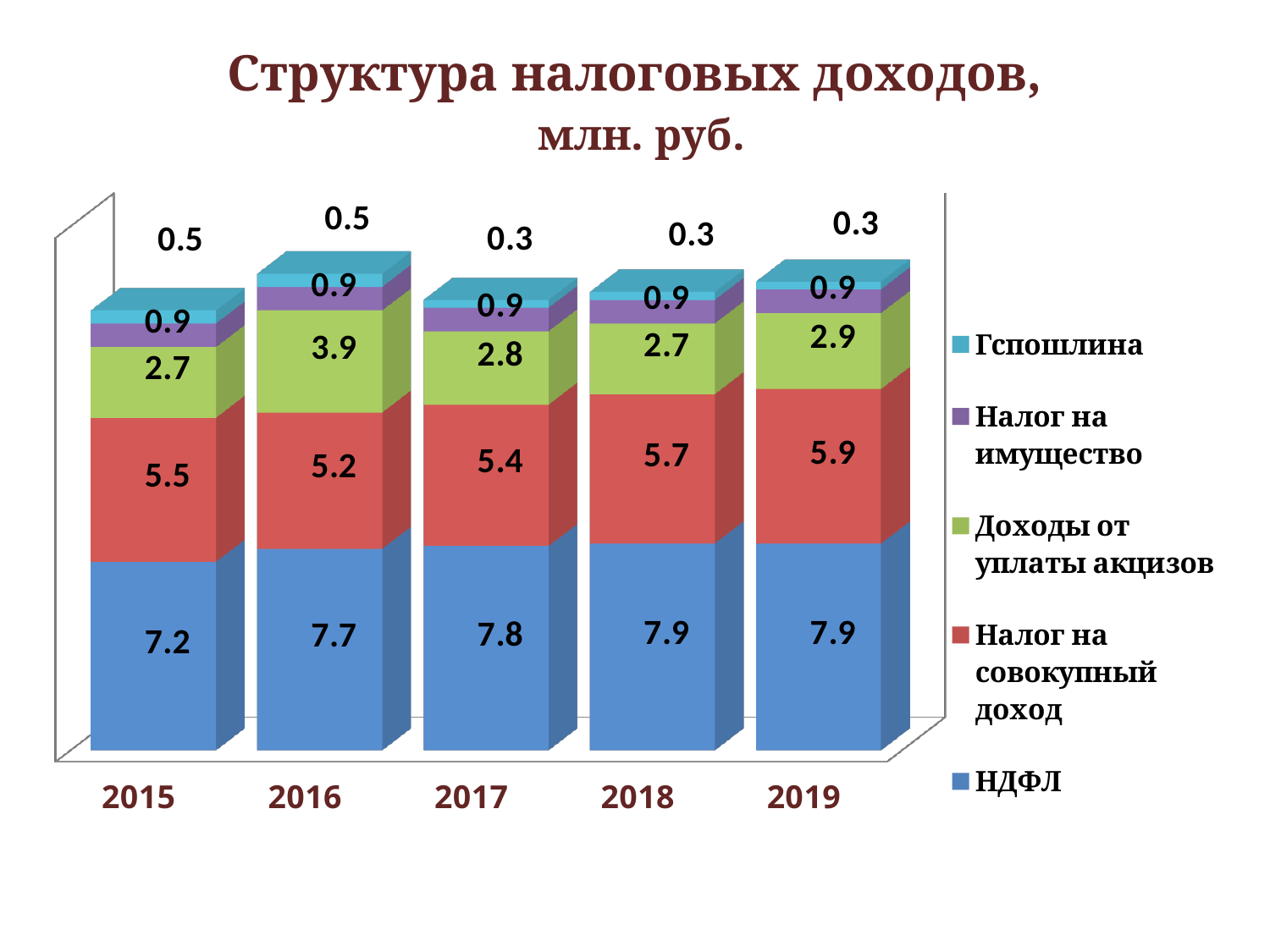
What is the value of Налог на совокупный доход in 2019? 5.9 In which year is НДФЛ lowest? 2015 Which is larger: Налог на совокупный доход in 2018 or in 2016? 2018 What is the total of the stacked bar for 2016? 18.2 What is the value of Доходы от уплаты акцизов in 2016? 3.9 What is the value of НДФЛ in 2015? 7.2 How many years are shown on the x axis? 5 In which year is Доходы от уплаты акцизов highest? 2016 What kind of chart is shown on the slide? Stacked bar chart How many series does the legend list? 5 What is the value of Госпошлина in 2017? 0.3 What is the difference between НДФЛ in 2016 and in 2015? 0.5